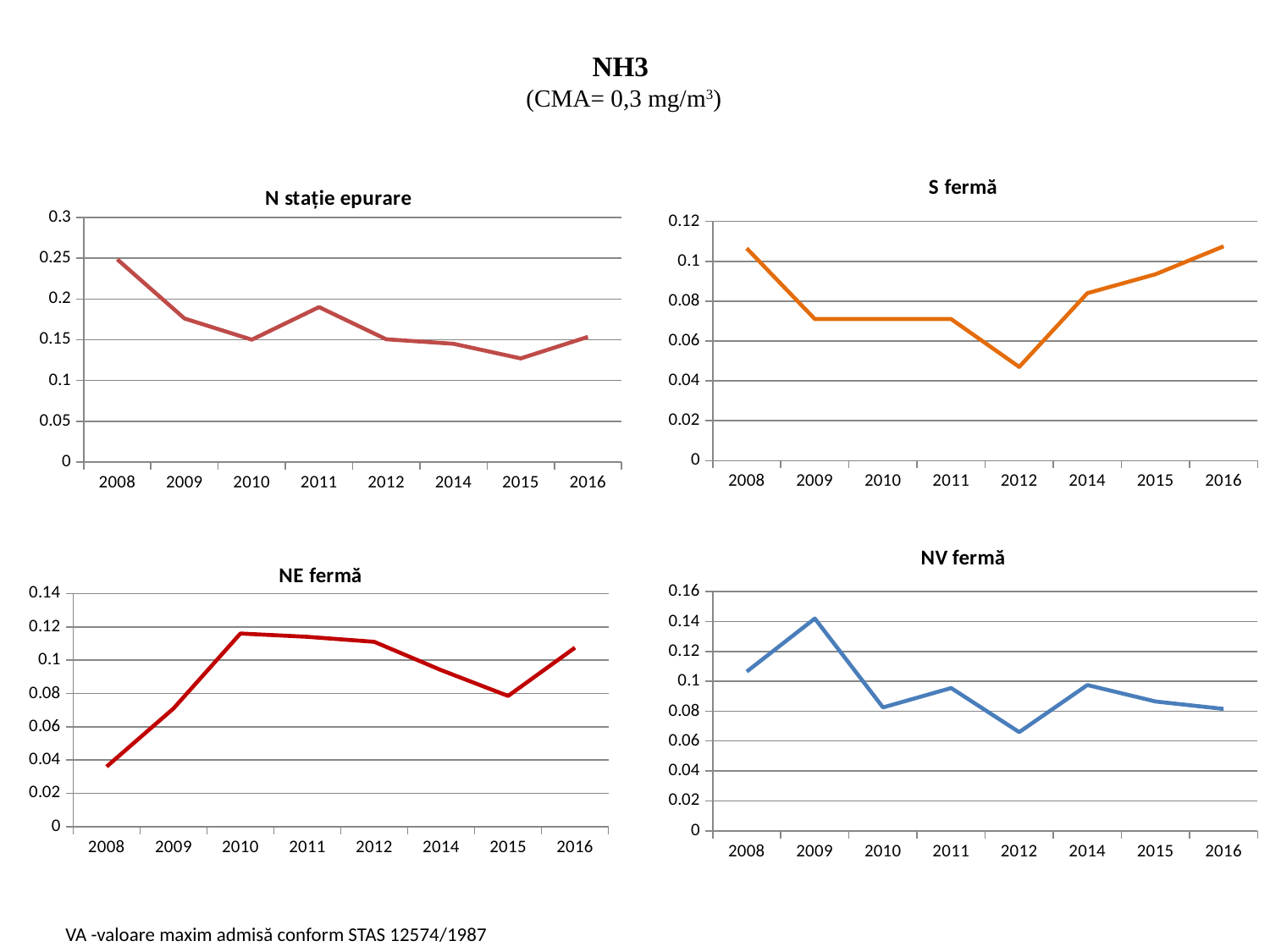
In the "N stație epurare" chart, which year has the lowest value? 2015 In the "NE fermă" chart, is the value for 2010 greater or less than 0.1? greater In the "S fermă" chart, is the value for 2012 greater or less than 0.06? less In the "S fermă" chart, which year has the lowest value? 2012 In the "NV fermă" chart, is the value for 2012 greater or less than 0.08? less In the "NE fermă" chart, which year has the lowest value? 2008 What kind of chart is the "N stație epurare" chart? line chart In the "N stație epurare" chart, which year has the highest value? 2008 How many years are plotted on the x axis of the "S fermă" chart? 8 In the "NV fermă" chart, which year has the highest value? 2009 In the "NE fermă" chart, do the values rise or fall from 2008 to 2010? rise